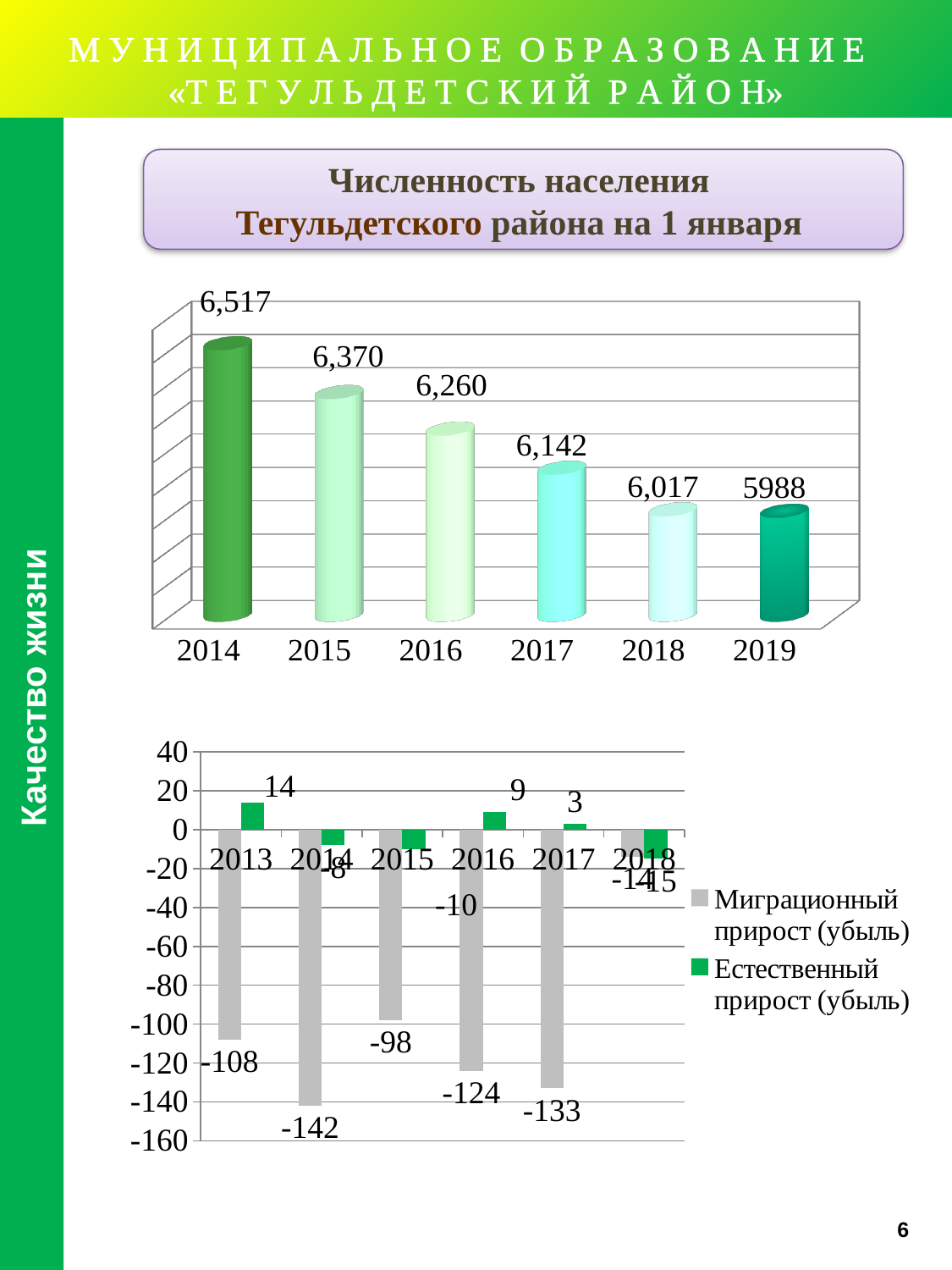
In the bottom chart, which is larger, the Миграционный прирост (убыль) value for 2015 or for 2017? 2015 In the top chart (Численность населения), which year has the lowest population? 2019 In the top chart (Численность населения), how many years are shown? 6 In the top chart (Численность населения), what is the population value for 2014? 6,517 What kind of chart is the bottom chart? bar chart In the bottom chart, which year has the highest value of Естественный прирост (убыль)? 2013 In the bottom chart, what is the value of Естественный прирост (убыль) for 2016? 9 In the top chart (Численность населения), what is the difference between the 2014 and 2015 values? 147 In the top chart (Численность населения), do the values rise or fall from 2014 to 2019? fall In the top chart (Численность населения), what is the population value for 2017? 6,142 In the bottom chart, what is the value of Миграционный прирост (убыль) for 2014? -142 In the bottom chart, how many series does the legend list? 2